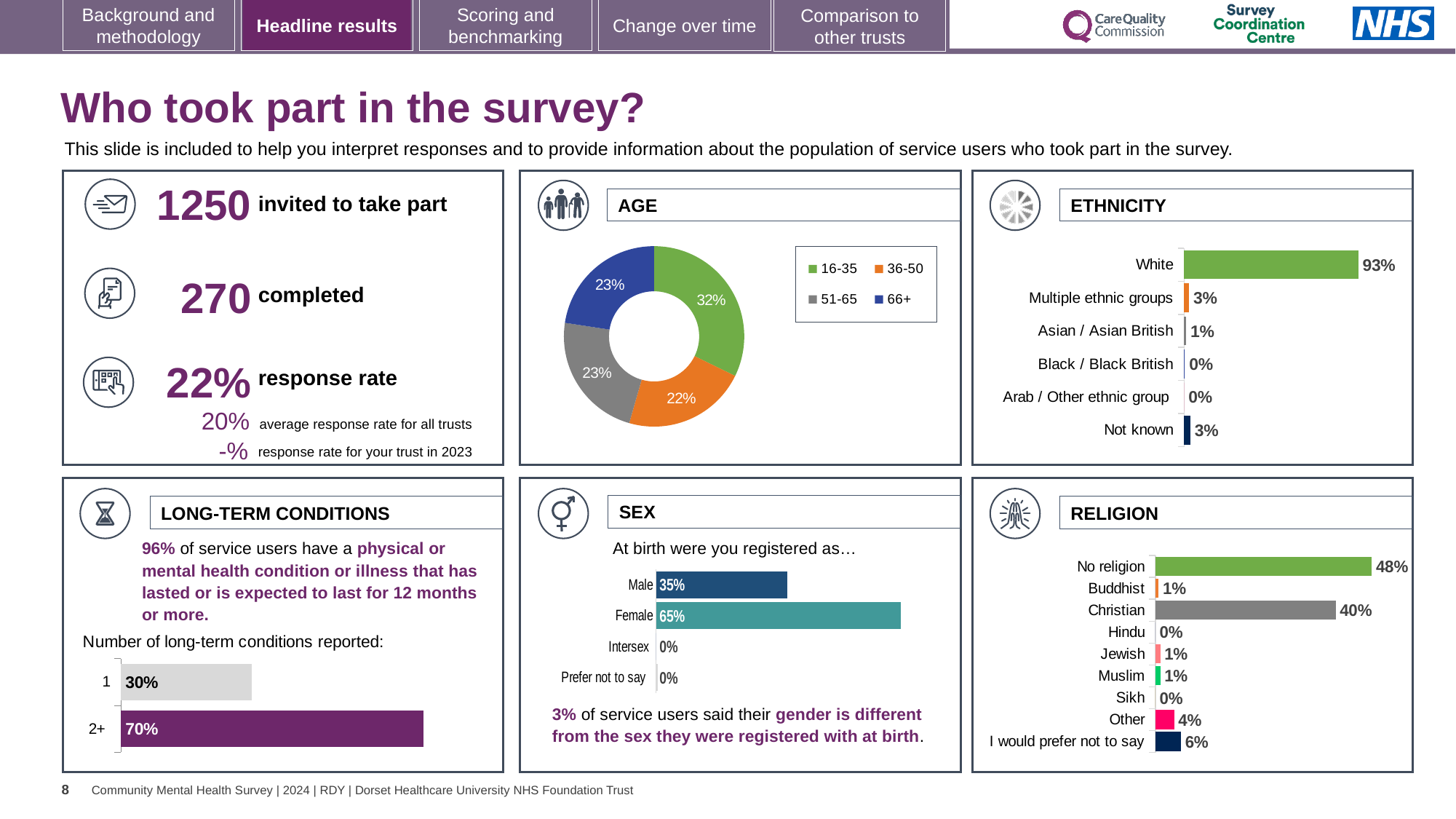
In the AGE chart, how many age groups does the legend list? 4 In the RELIGION chart, what is the value for Christian? 40% In the ETHNICITY chart, which category has the highest value? White In the LONG-TERM CONDITIONS chart, what is the difference between the 2+ and 1 bars? 40% In the SEX chart, what is the value for Female? 65% In the ETHNICITY chart, what is the difference between White and Multiple ethnic groups? 90% In the ETHNICITY chart, how many categories are shown? 6 In the ETHNICITY chart, what is the value for White? 93% In the AGE chart, what share of respondents were aged 16-35? 32% In the AGE chart, what kind of chart is used? Doughnut (pie) chart In the RELIGION chart, which category has the highest value? No religion In the SEX chart, which is larger, Male or Female? Female